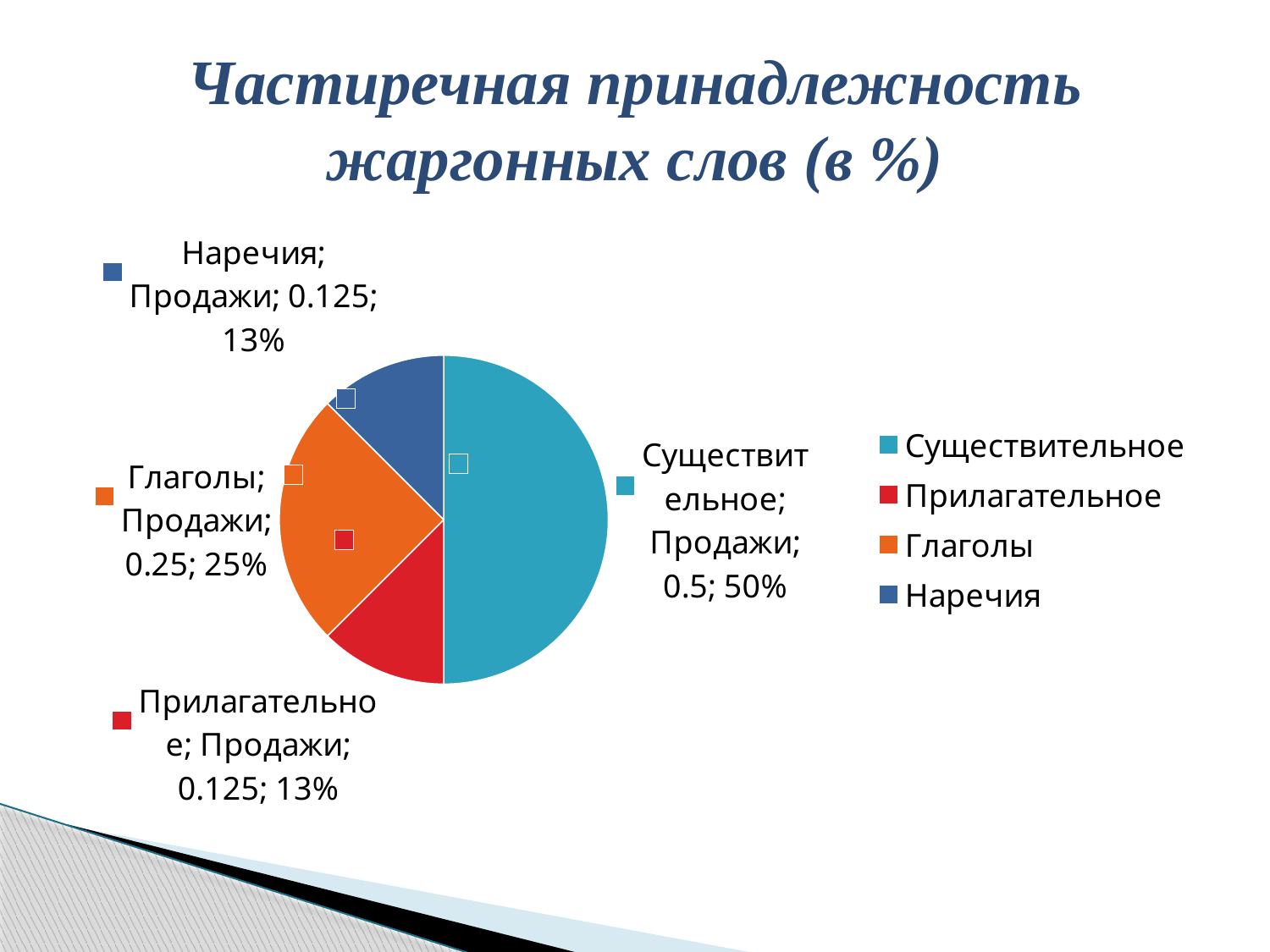
How many entries does the legend list? 4 What is the title of the chart on the slide? Частиречная принадлежность жаргонных слов (в %) How many categories are shown in the pie chart? 4 What percentage is shown for Глаголы? 25% What percentage is shown for Наречия? 13% What percentage is shown for Существительное? 50% Which category has the largest slice of the pie? Существительное What share of the pie does Глаголы take? 25% Which is larger, the slice for Глаголы or the slice for Наречия? Глаголы What value (as a fraction) is shown for Прилагательное? 0.125 What kind of chart is shown on the slide? pie chart What is the difference in percentage points between Существительное and Глаголы? 25